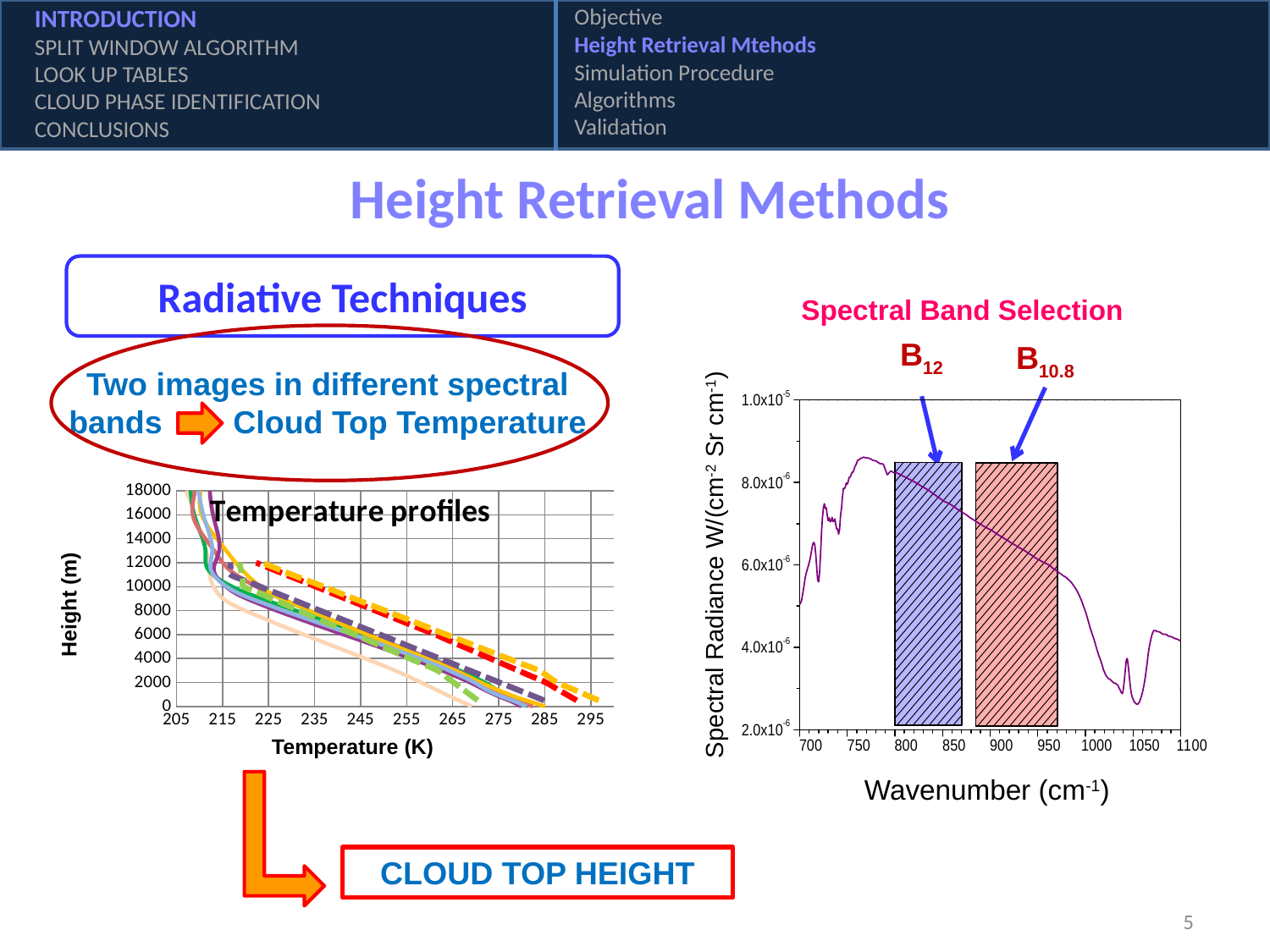
In the Spectral Band Selection chart, is the spectral radiance at wavenumber 1100 greater or less than 6.0x10-6? less What kind of chart is the Spectral Band Selection chart? line chart In the Spectral Band Selection chart, does the spectral radiance rise or fall between wavenumbers 800 and 1000? fall How many spectral bands are highlighted with shaded rectangles in the Spectral Band Selection chart? 2 In the Spectral Band Selection chart, which highlighted band lies at the lower wavenumbers, B12 or B10.8? B12 In the Temperature profiles chart, is the height of the profiles at 285 K greater or less than 8000 m? less In the Temperature profiles chart, as temperature increases along the x axis, do the profile heights rise or fall? fall In the Spectral Band Selection chart, is the spectral radiance at wavenumber 800 greater or less than 6.0x10-6? greater What kind of chart is the Temperature profiles chart? line chart What is the x-axis label of the Spectral Band Selection chart? Wavenumber (cm-1) What is the x-axis label of the Temperature profiles chart? Temperature (K)